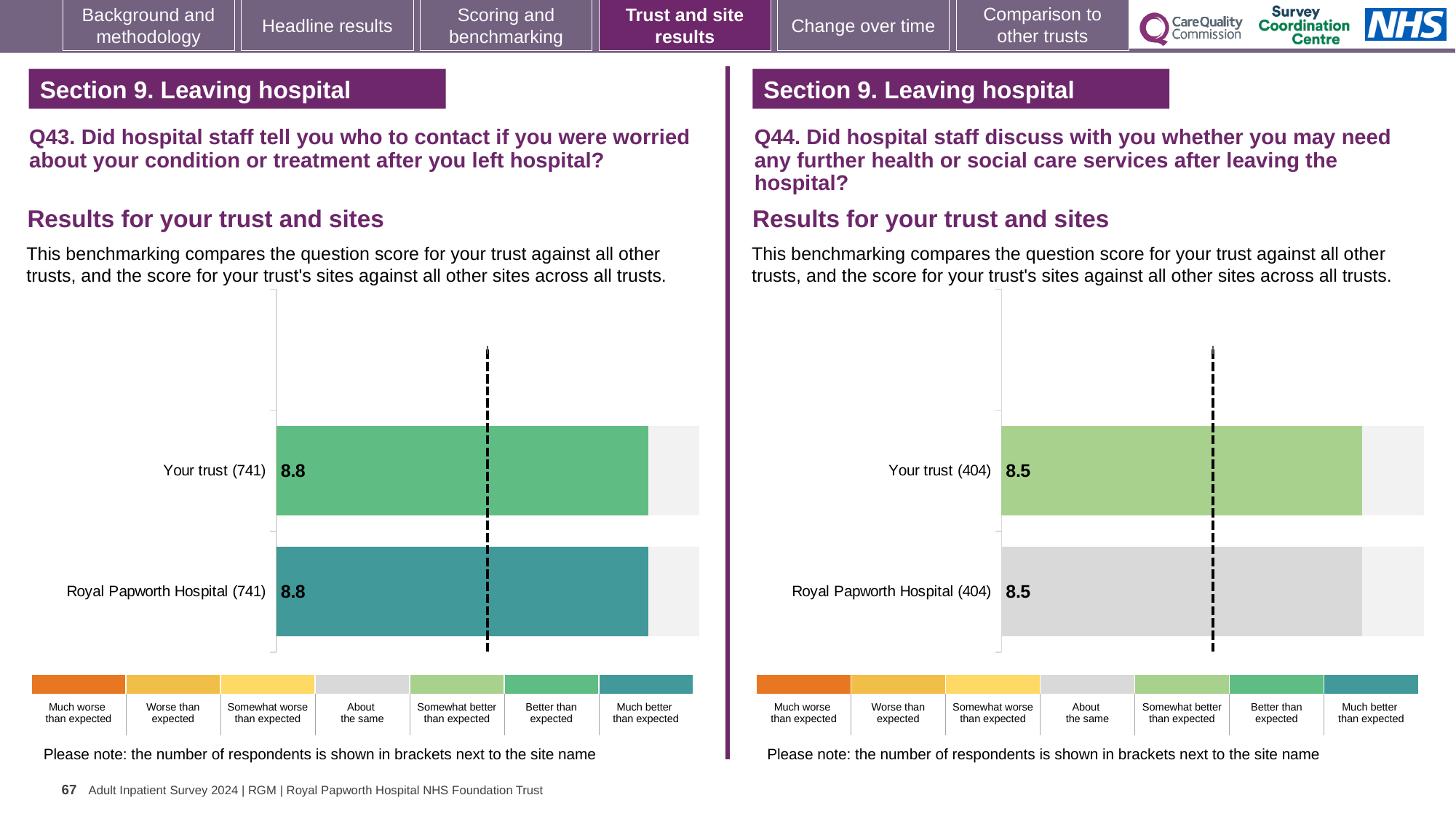
On the Q44 chart (right), what is the difference between the Your trust score and the Royal Papworth Hospital score? 0 On the Q43 chart (left), what is the score for Royal Papworth Hospital? 8.8 How many bars are plotted on the Q43 chart (left)? 2 On the Q43 chart (left), how many respondents are shown in brackets for Your trust? 741 On the Q44 chart (right), which benchmark category does the grey colour of the Royal Papworth Hospital bar correspond to in the legend? About the same How many bars are plotted on the Q44 chart (right)? 2 On the Q43 chart (left), what is the score for Your trust? 8.8 On the Q43 chart (left), what is the difference between the Your trust score and the Royal Papworth Hospital score? 0 On the Q44 chart (right), how many respondents are shown in brackets for Royal Papworth Hospital? 404 What type of chart is used on the Q43 chart (left)? Bar chart On the Q44 chart (right), what is the score for Your trust? 8.5 On the Q44 chart (right), what is the score for Royal Papworth Hospital? 8.5